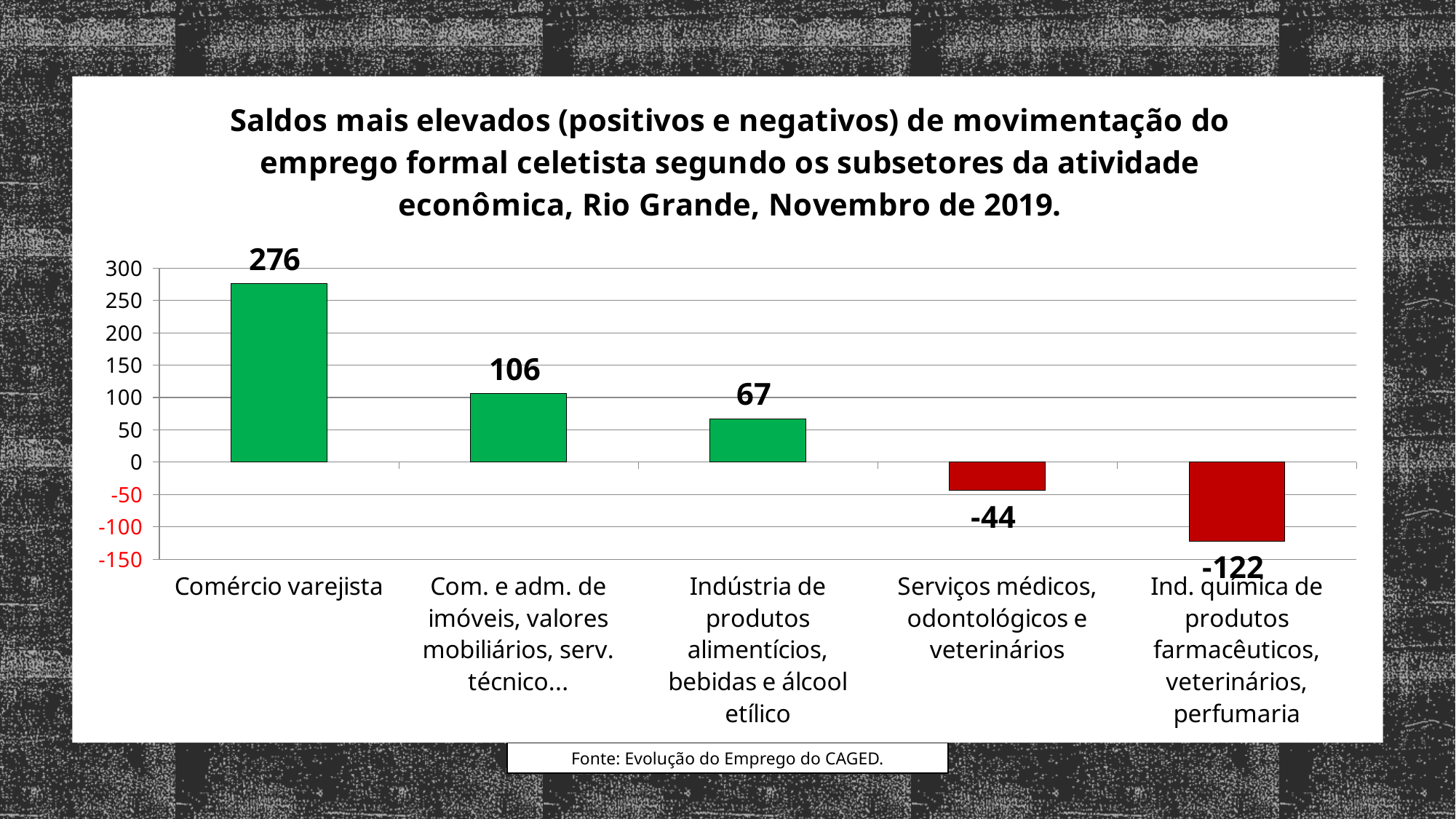
How many categories are shown in the chart? 5 Which category has the highest value? Comércio varejista Which is larger, the value for Com. e adm. de imóveis, valores mobiliários, serv. técnico... or the value for Indústria de produtos alimentícios, bebidas e álcool etílico? Com. e adm. de imóveis, valores mobiliários, serv. técnico... What colour are the bars with negative values? Red What is the value for Serviços médicos, odontológicos e veterinários? -44 What is the difference between the values for Comércio varejista and Com. e adm. de imóveis, valores mobiliários, serv. técnico...? 170 What kind of chart is shown on the slide? Bar chart Is the value for Comércio varejista greater or less than 250? greater What is the value for Comércio varejista? 276 What is the value for Ind. química de produtos farmacêuticos, veterinários, perfumaria? -122 What is the value for Indústria de produtos alimentícios, bebidas e álcool etílico? 67 Which category has the lowest value? Ind. química de produtos farmacêuticos, veterinários, perfumaria